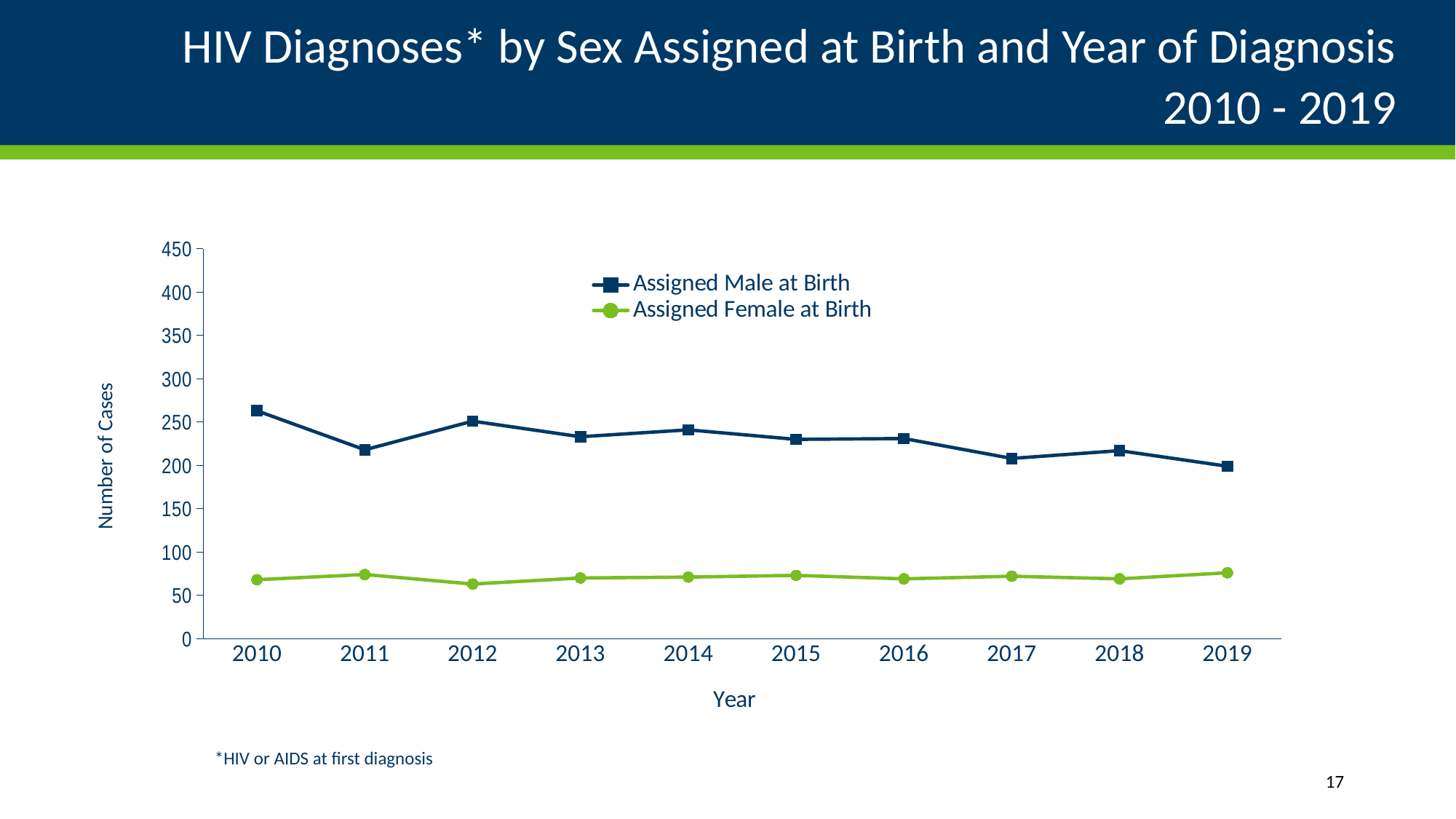
In which year is the value for Assigned Female at Birth lowest? 2012 Is the value for Assigned Male at Birth in 2011 greater or less than 250? less How many years are plotted along the x axis? 10 Is the value for Assigned Male at Birth in 2010 greater or less than 250? greater What kind of chart is shown on the slide? line chart Is the value for Assigned Female at Birth in 2015 greater or less than 100? less In which year is the value for Assigned Male at Birth highest? 2010 How many series does the legend list? 2 Does the Assigned Male at Birth series rise or fall overall from 2010 to 2019? fall What is the label on the y axis? Number of Cases Which is larger for Assigned Male at Birth: the value in 2010 or the value in 2011? 2010